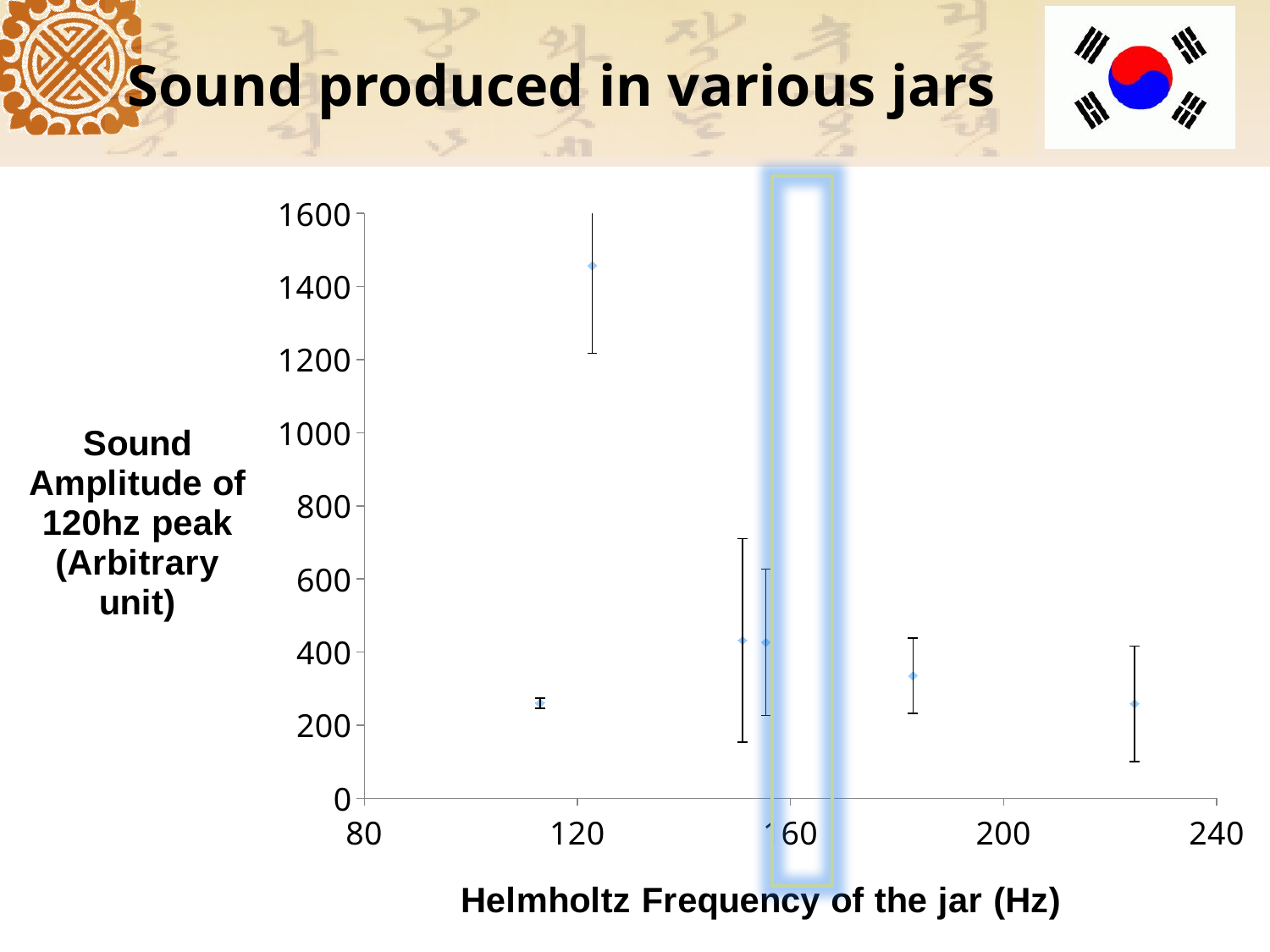
What is the label of the x axis? Helmholtz Frequency of the jar (Hz) Which data point has the highest sound amplitude? The point near 120 Hz Is the sound amplitude of the point near 183 Hz greater or less than 600? less Which has the larger sound amplitude: the point near 120 Hz or the point near 225 Hz? The point near 120 Hz Is the sound amplitude of the point near 225 Hz greater or less than 400? less Is the sound amplitude of the point near 113 Hz greater or less than 200? greater Which has the larger sound amplitude: the point near 150 Hz or the point near 183 Hz? The point near 150 Hz How many data points are plotted on the chart? 6 What kind of chart is shown on the slide? Scatter chart What is the title of the chart? Sound produced in various jars What is the maximum value shown on the y axis? 1600